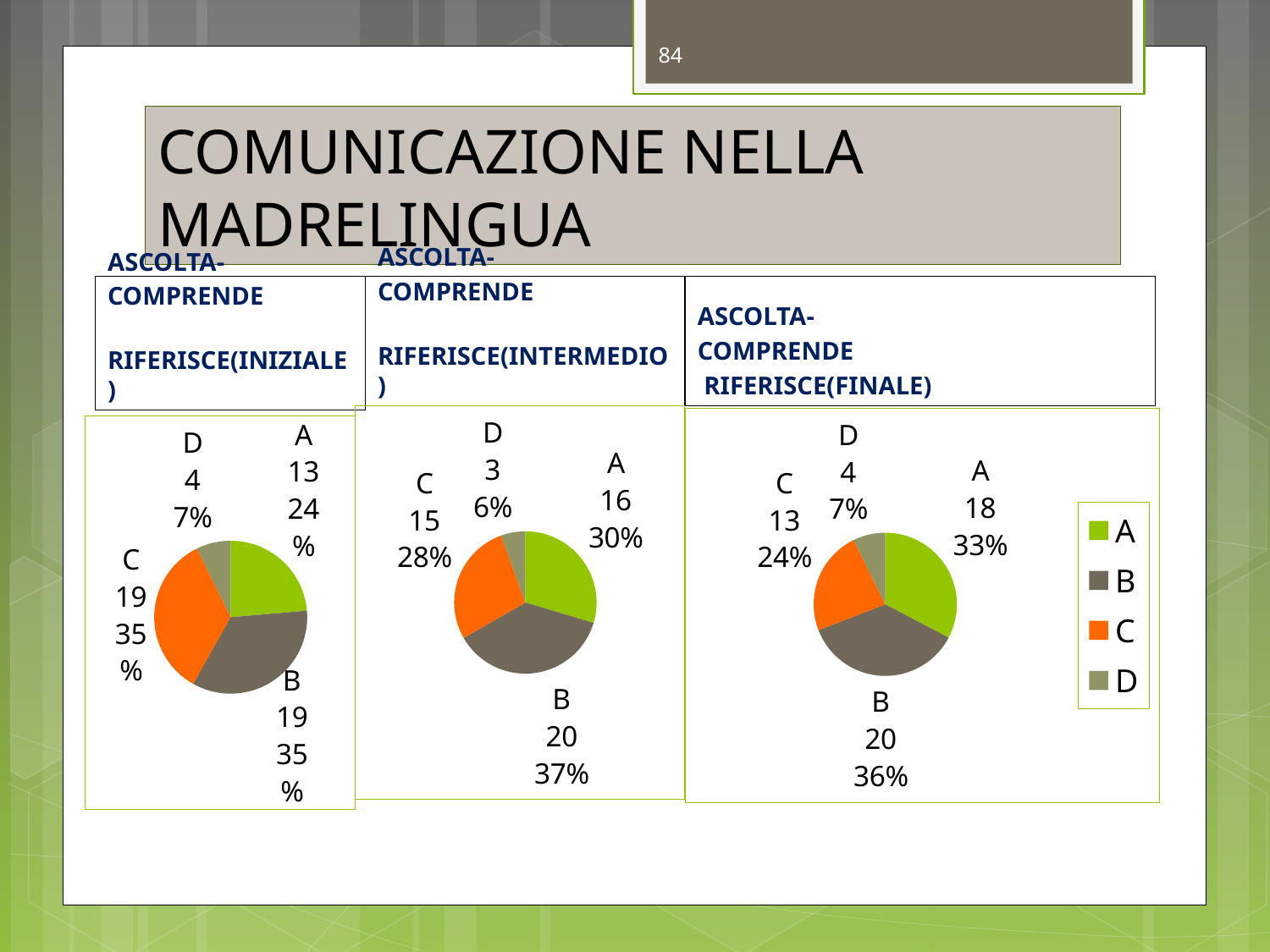
In the ASCOLTA-COMPRENDE RIFERISCE(INTERMEDIO) pie chart, which category has the largest slice? B In the ASCOLTA-COMPRENDE RIFERISCE(FINALE) pie chart, what is the difference between the counts for B and C? 7 In the ASCOLTA-COMPRENDE RIFERISCE(INTERMEDIO) pie chart, which category has the smallest slice? D In the legend on the right of the slide, which colour represents category C? Orange In the ASCOLTA-COMPRENDE RIFERISCE(INTERMEDIO) pie chart, what is the count for category C? 15 In the ASCOLTA-COMPRENDE RIFERISCE(FINALE) pie chart, which is larger, the count for A or the count for C? A How many categories does each pie chart on the slide show? 4 In the ASCOLTA-COMPRENDE RIFERISCE(FINALE) pie chart, what percentage share does category A have? 33% What type of chart is used for the ASCOLTA-COMPRENDE RIFERISCE(INIZIALE) data? Pie chart In the ASCOLTA-COMPRENDE RIFERISCE(INIZIALE) pie chart, what is the count for category A? 13 How many entries does the legend on the right of the slide list? 4 In the ASCOLTA-COMPRENDE RIFERISCE(INIZIALE) pie chart, what percentage share does category D have? 7%